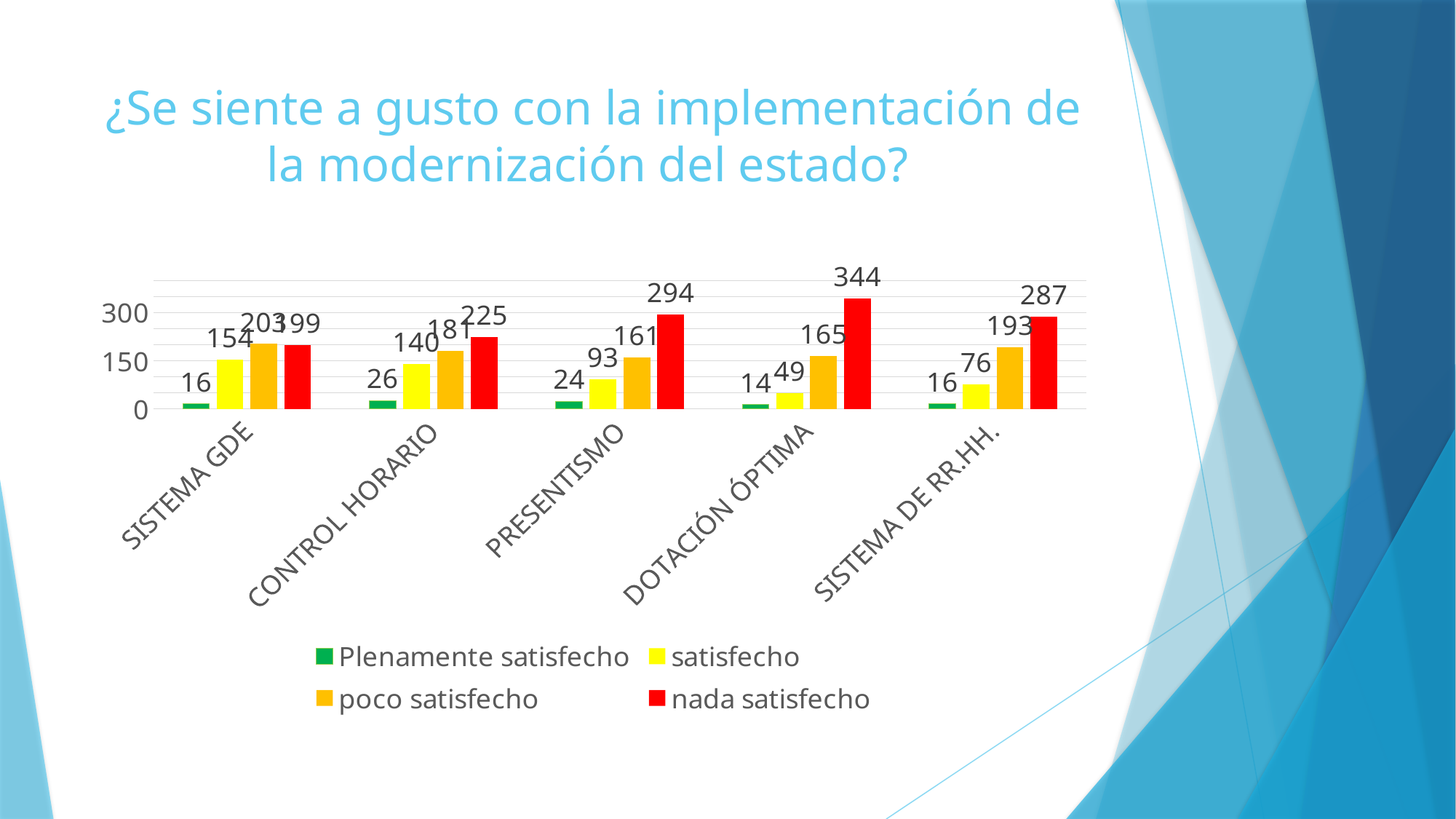
How many series does the chart's legend list? 4 What is the value of 'Plenamente satisfecho' for SISTEMA DE RR.HH.? 16 What is the value of 'satisfecho' for CONTROL HORARIO? 140 Which category has the lowest 'satisfecho' value? DOTACIÓN ÓPTIMA How many categories are shown on the x axis of the chart? 5 What is the value of 'nada satisfecho' for DOTACIÓN ÓPTIMA? 344 What kind of chart is shown on the slide? bar chart What is the value of 'poco satisfecho' for PRESENTISMO? 161 Which is larger: 'poco satisfecho' for SISTEMA DE RR.HH. or 'poco satisfecho' for CONTROL HORARIO? SISTEMA DE RR.HH. Which legend entry is shown in red? nada satisfecho What is the difference between the 'nada satisfecho' values for DOTACIÓN ÓPTIMA and PRESENTISMO? 50 Which category has the highest 'nada satisfecho' value? DOTACIÓN ÓPTIMA